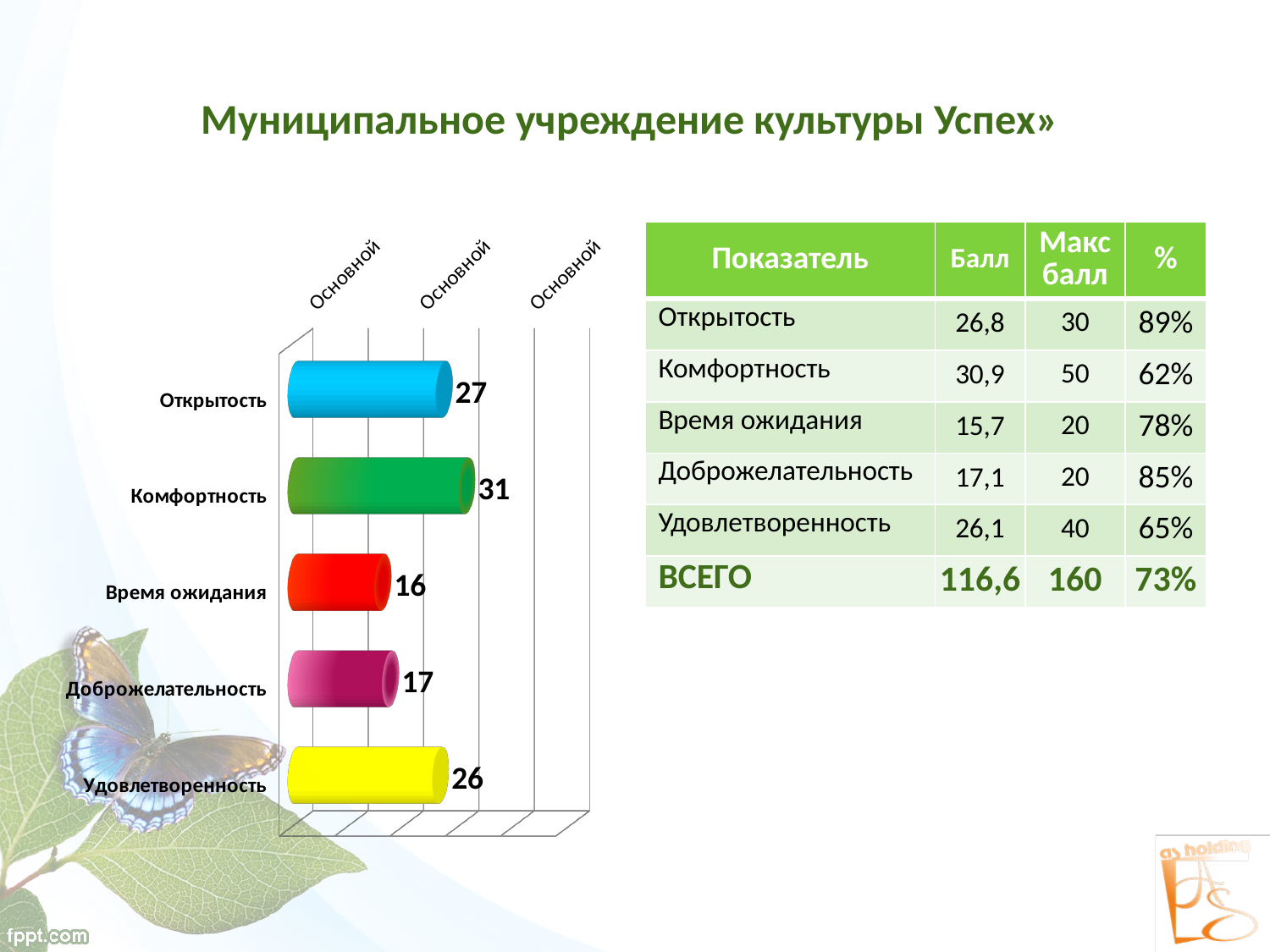
What colour is the bar for Время ожидания in the bar chart? Red How many categories are shown in the bar chart? 5 What value is shown for Открытость in the bar chart? 27 Which is larger in the bar chart, the value for Открытость or the value for Удовлетворенность? Открытость Which category has the lowest value in the bar chart? Время ожидания What value is shown for Удовлетворенность in the bar chart? 26 Which category has the highest value in the bar chart? Комфортность What kind of chart is shown on the slide? Bar chart What value is shown for Время ожидания in the bar chart? 16 What is the difference between the values for Комфортность and Время ожидания in the bar chart? 15 What value is shown for Комфортность in the bar chart? 31 What value is shown for Доброжелательность in the bar chart? 17